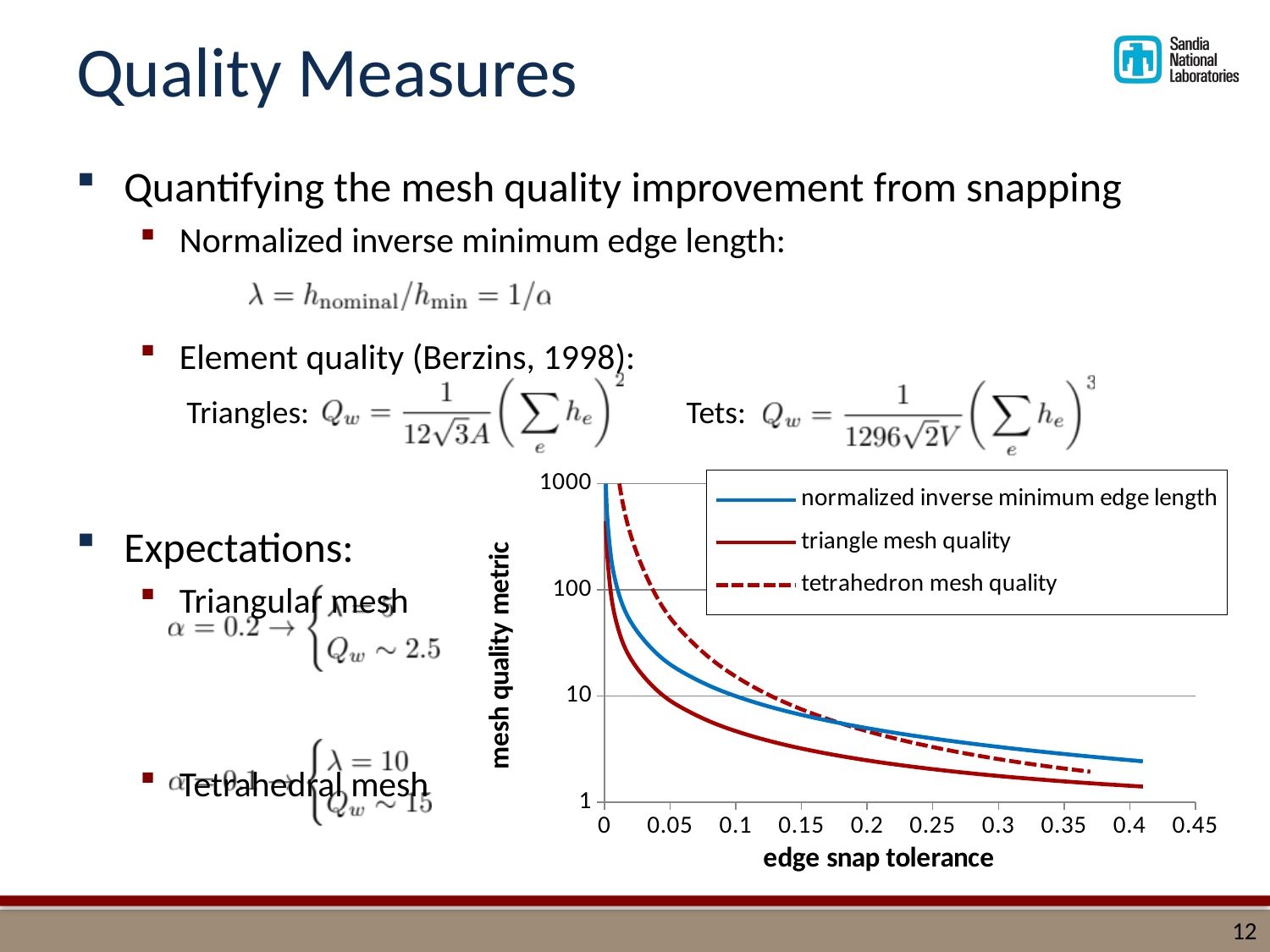
What is the label of the y axis of the chart? mesh quality metric How many series does the chart legend list? 3 What is the label of the x axis of the chart? edge snap tolerance Is the value of the normalized inverse minimum edge length series at edge snap tolerance 0.4 greater or less than 10? less At edge snap tolerance 0.3, which series has the larger value: normalized inverse minimum edge length or triangle mesh quality? normalized inverse minimum edge length Do the values of the normalized inverse minimum edge length series rise or fall along the x axis? fall Do the values of the triangle mesh quality series rise or fall as edge snap tolerance increases? fall Is the value of the triangle mesh quality series at edge snap tolerance 0.2 greater or less than 10? less Is the value of the tetrahedron mesh quality series at edge snap tolerance 0.1 greater or less than 10? greater At edge snap tolerance 0.1, which series has the larger value: tetrahedron mesh quality or normalized inverse minimum edge length? tetrahedron mesh quality At edge snap tolerance 0.05, which series has the larger value: tetrahedron mesh quality or triangle mesh quality? tetrahedron mesh quality What kind of chart is shown on the slide? line chart